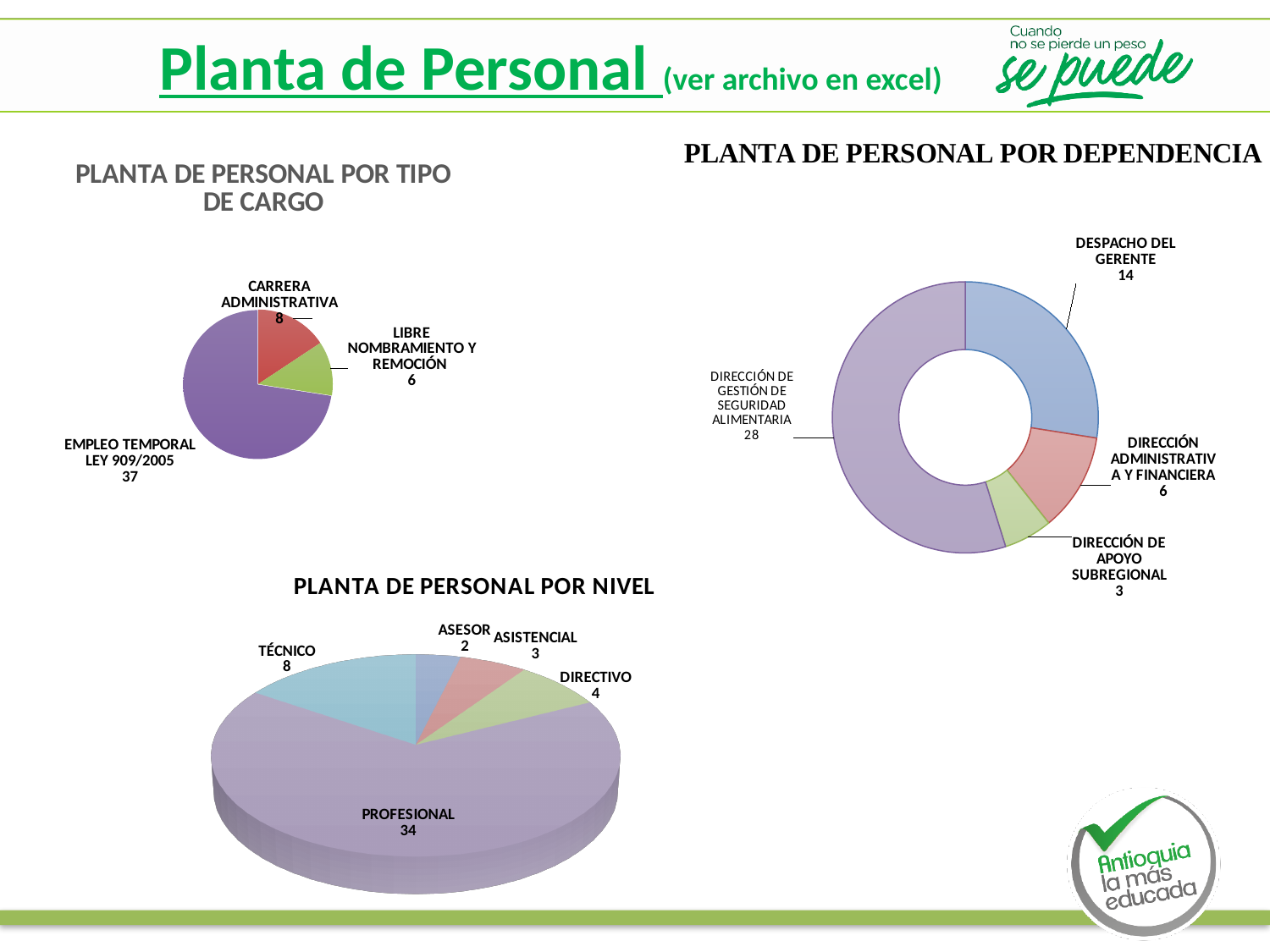
In the 'PLANTA DE PERSONAL POR DEPENDENCIA' chart, what is the value for DESPACHO DEL GERENTE? 14 In the 'PLANTA DE PERSONAL POR TIPO DE CARGO' chart, what is the difference between EMPLEO TEMPORAL LEY 909/2005 and CARRERA ADMINISTRATIVA? 29 In the 'PLANTA DE PERSONAL POR DEPENDENCIA' chart, which category has the highest value? DIRECCIÓN DE GESTIÓN DE SEGURIDAD ALIMENTARIA In the 'PLANTA DE PERSONAL POR NIVEL' chart, what is the value for TÉCNICO? 8 In the 'PLANTA DE PERSONAL POR TIPO DE CARGO' chart, what is the value for EMPLEO TEMPORAL LEY 909/2005? 37 In the 'PLANTA DE PERSONAL POR NIVEL' chart, what is the difference between PROFESIONAL and DIRECTIVO? 30 What kind of chart is 'PLANTA DE PERSONAL POR DEPENDENCIA'? Doughnut chart In the 'PLANTA DE PERSONAL POR TIPO DE CARGO' chart, how many categories are shown? 3 In the 'PLANTA DE PERSONAL POR NIVEL' chart, which category has the lowest value? ASESOR In the 'PLANTA DE PERSONAL POR DEPENDENCIA' chart, which is larger: DIRECCIÓN ADMINISTRATIVA Y FINANCIERA or DIRECCIÓN DE APOYO SUBREGIONAL? DIRECCIÓN ADMINISTRATIVA Y FINANCIERA In the 'PLANTA DE PERSONAL POR NIVEL' chart, how many categories are shown? 5 In the 'PLANTA DE PERSONAL POR TIPO DE CARGO' chart, which category has the lowest value? LIBRE NOMBRAMIENTO Y REMOCIÓN